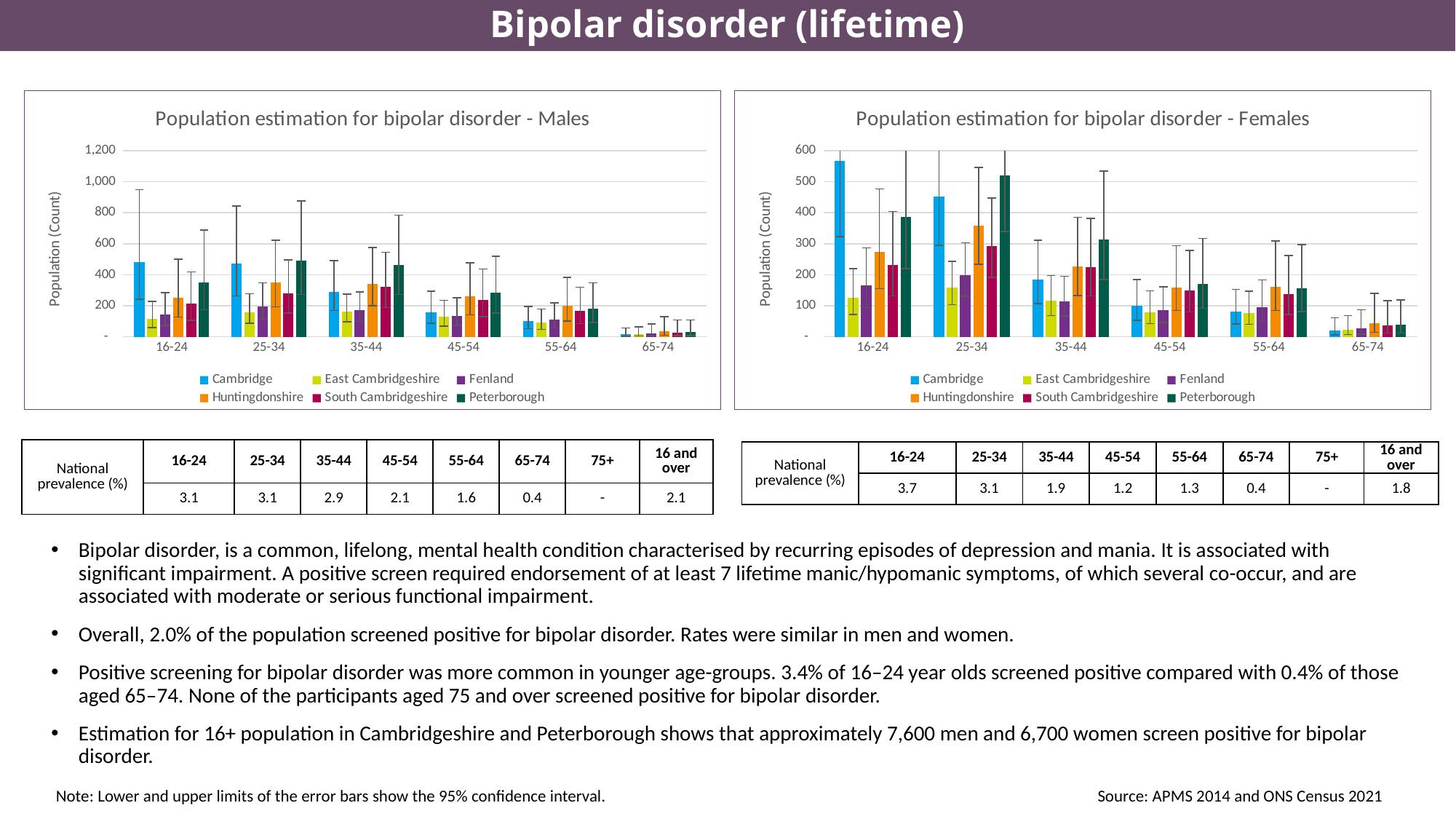
In the 'Population estimation for bipolar disorder - Females' chart, is the value for Cambridge in the 16-24 age group greater or less than 500? greater In the 'Population estimation for bipolar disorder - Females' chart, is the value for Huntingdonshire in the 25-34 age group greater or less than 300? greater In the 'Population estimation for bipolar disorder - Males' chart, is the value for Cambridge in the 16-24 age group greater or less than 400? greater What type of chart is 'Population estimation for bipolar disorder - Males'? bar chart In the 'Population estimation for bipolar disorder - Females' chart, which area has the highest bar in the 16-24 age group? Cambridge In the 'Population estimation for bipolar disorder - Males' chart, which age group has the lowest bars overall? 65-74 In the 'Population estimation for bipolar disorder - Males' chart, which is larger in the 16-24 age group: Cambridge or Huntingdonshire? Cambridge In the 'Population estimation for bipolar disorder - Females' chart, do the Cambridge bars generally rise or fall from the 16-24 age group to the 65-74 age group? fall How many age-group categories are shown on the x axis of the 'Population estimation for bipolar disorder - Females' chart? 6 How many series does the legend of the 'Population estimation for bipolar disorder - Males' chart list? 6 What is the y-axis label on the 'Population estimation for bipolar disorder - Females' chart? Population (Count)